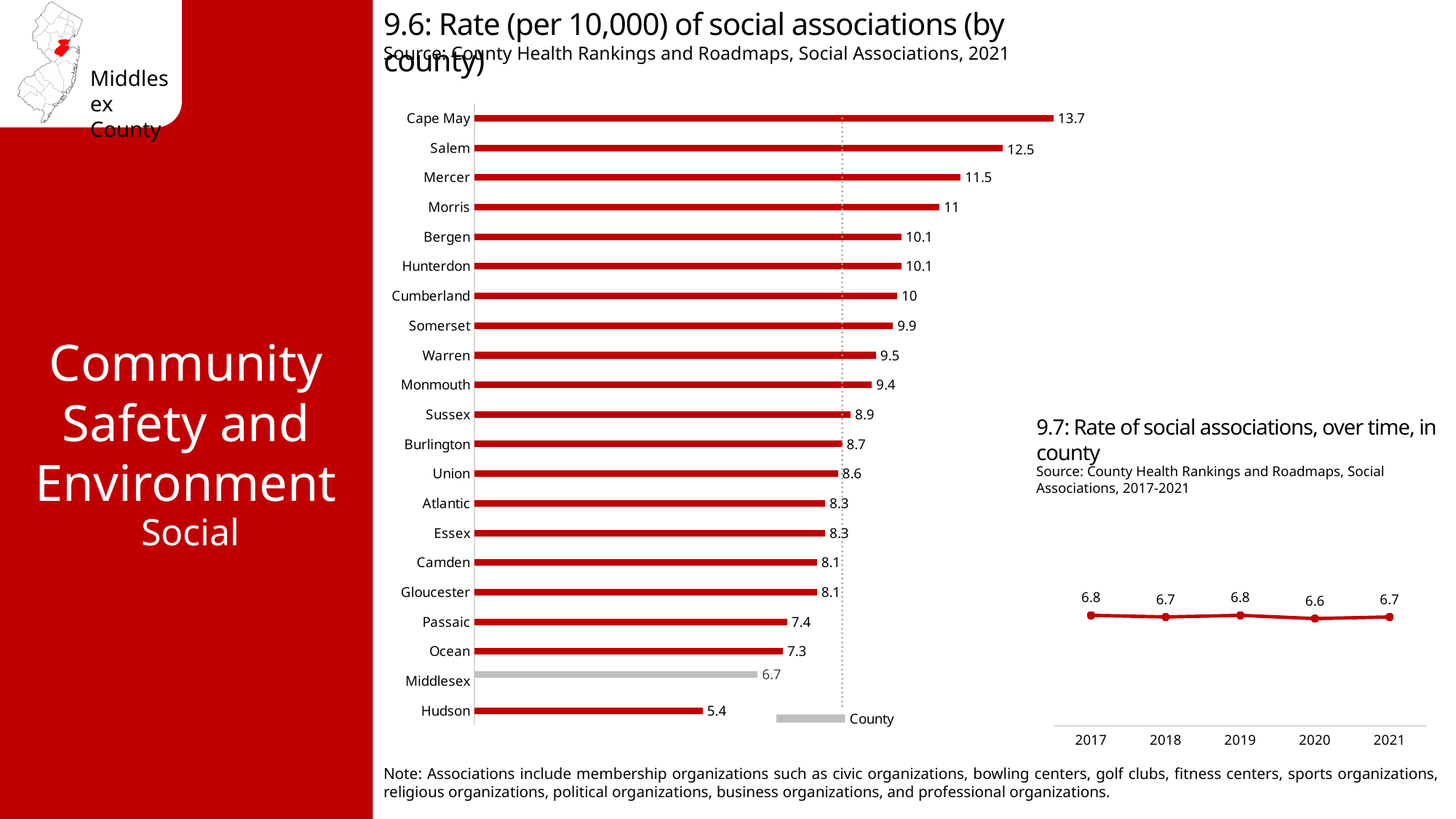
What kind of chart is '9.7: Rate of social associations, over time, in county'? Line chart In the chart '9.6: Rate (per 10,000) of social associations (by county)', how many counties are shown? 21 In the chart '9.7: Rate of social associations, over time, in county', what is the value for 2020? 6.6 In the chart '9.7: Rate of social associations, over time, in county', how many years are plotted? 5 In the chart '9.6: Rate (per 10,000) of social associations (by county)', what is the value for Middlesex? 6.7 In the chart '9.6: Rate (per 10,000) of social associations (by county)', which county has the lowest rate? Hudson In the chart '9.7: Rate of social associations, over time, in county', which year has the lowest value? 2020 In the chart '9.6: Rate (per 10,000) of social associations (by county)', what is the difference between Cape May and Hudson? 8.3 In the chart '9.6: Rate (per 10,000) of social associations (by county)', what is the value for Mercer? 11.5 In the chart '9.6: Rate (per 10,000) of social associations (by county)', which is larger, Salem or Morris? Salem What kind of chart is '9.6: Rate (per 10,000) of social associations (by county)'? Bar chart In the chart '9.6: Rate (per 10,000) of social associations (by county)', which county has the highest rate? Cape May